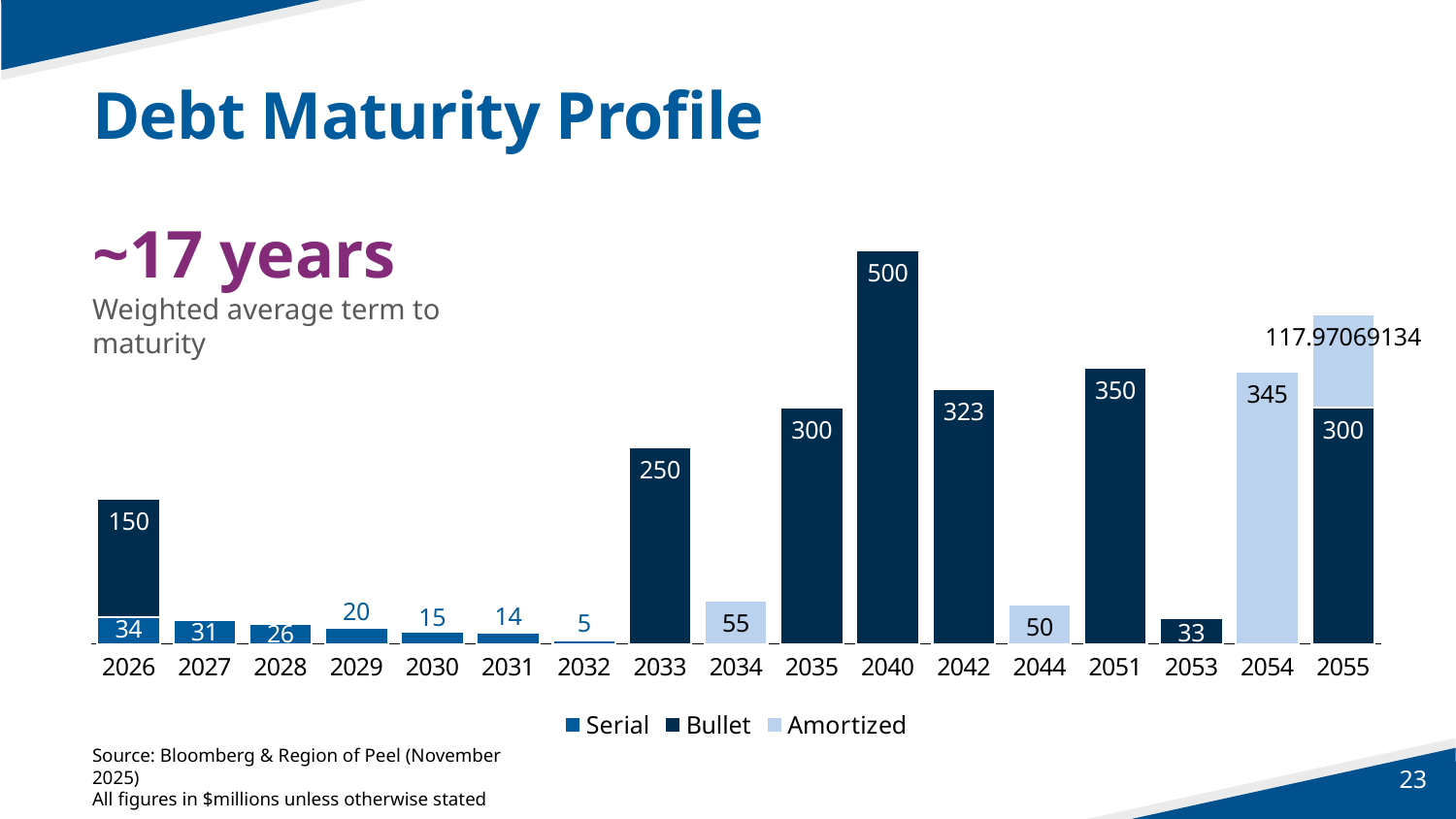
Which is larger, the Bullet value for 2033 or the Bullet value for 2042? 2042 Which year has the lowest Serial value? 2032 What is the difference between the Bullet values for 2040 and 2051? 150 What is the Serial value for 2026? 34 Which year has the highest Bullet value? 2040 What is the total of the stacked bar for 2026? 184 How many years are shown on the x axis? 17 How many series does the legend list? 3 What is the Amortized value for 2034? 55 What kind of chart is shown on the slide? Stacked bar chart What is the Amortized value for 2054? 345 What is the Bullet value for 2040? 500